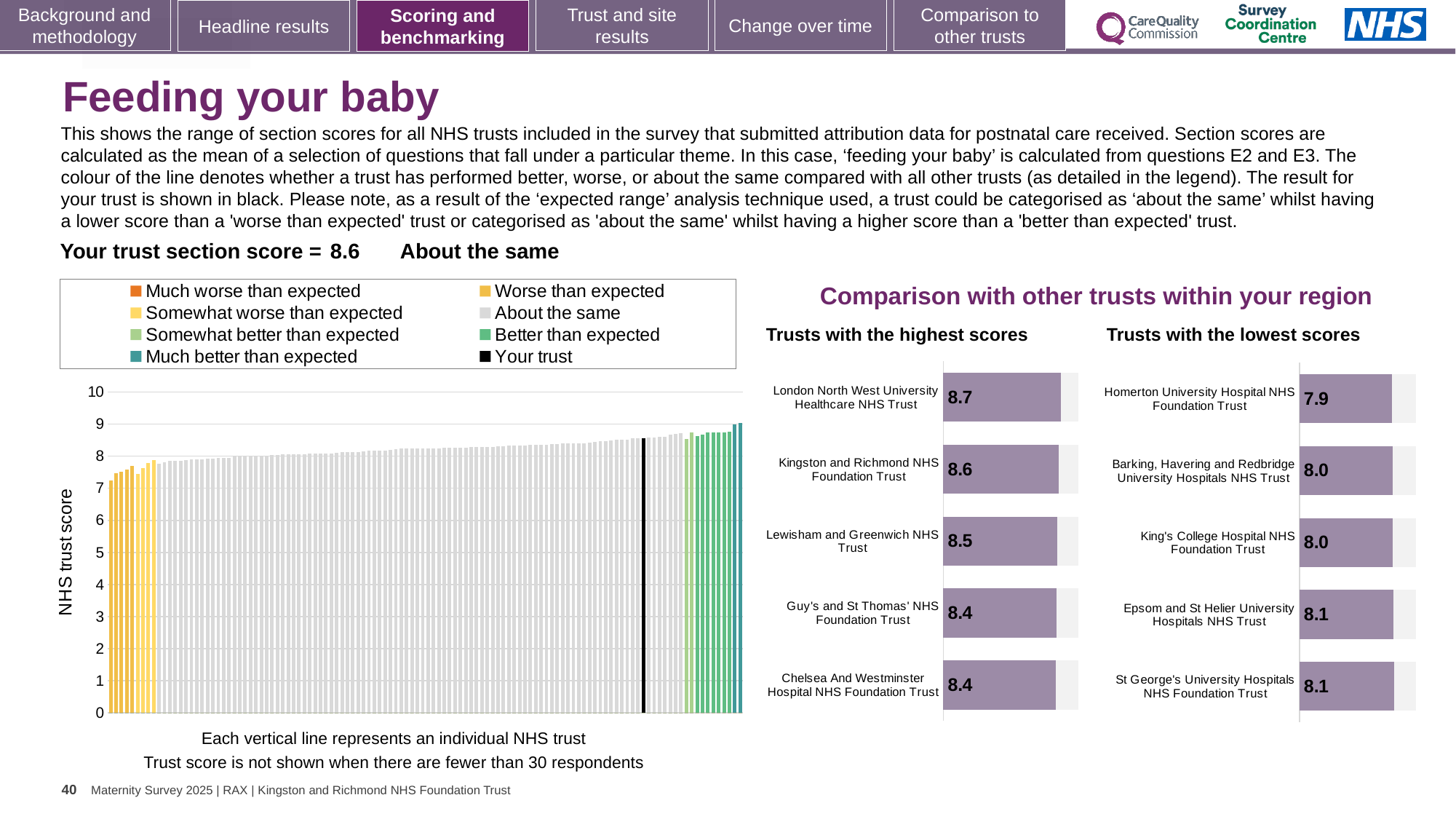
How many entries does the legend above the 'NHS trust score' chart list? 8 In the 'Trusts with the highest scores' chart, which trust has the highest score? London North West University Healthcare NHS Trust What is the label on the vertical axis of the large chart on the left? NHS trust score In the 'Trusts with the highest scores' chart, what is the score for London North West University Healthcare NHS Trust? 8.7 In the 'NHS trust score' chart on the left, is the value of the black 'Your trust' bar greater or less than 8? greater In the 'Trusts with the lowest scores' chart, which trust has the lowest score? Homerton University Hospital NHS Foundation Trust In the 'Trusts with the lowest scores' chart, what is the score for Homerton University Hospital NHS Foundation Trust? 7.9 In the 'Trusts with the highest scores' chart, what is the difference between the scores of London North West University Healthcare NHS Trust and Lewisham and Greenwich NHS Trust? 0.2 In the 'NHS trust score' chart on the left, do the bar values rise or fall from left to right? Rise What kind of chart is the large chart on the left with the 'NHS trust score' axis? Bar chart In the 'Trusts with the highest scores' chart, which has the larger score: Kingston and Richmond NHS Foundation Trust or Guy's and St Thomas' NHS Foundation Trust? Kingston and Richmond NHS Foundation Trust How many trusts are listed in the 'Trusts with the lowest scores' chart? 5